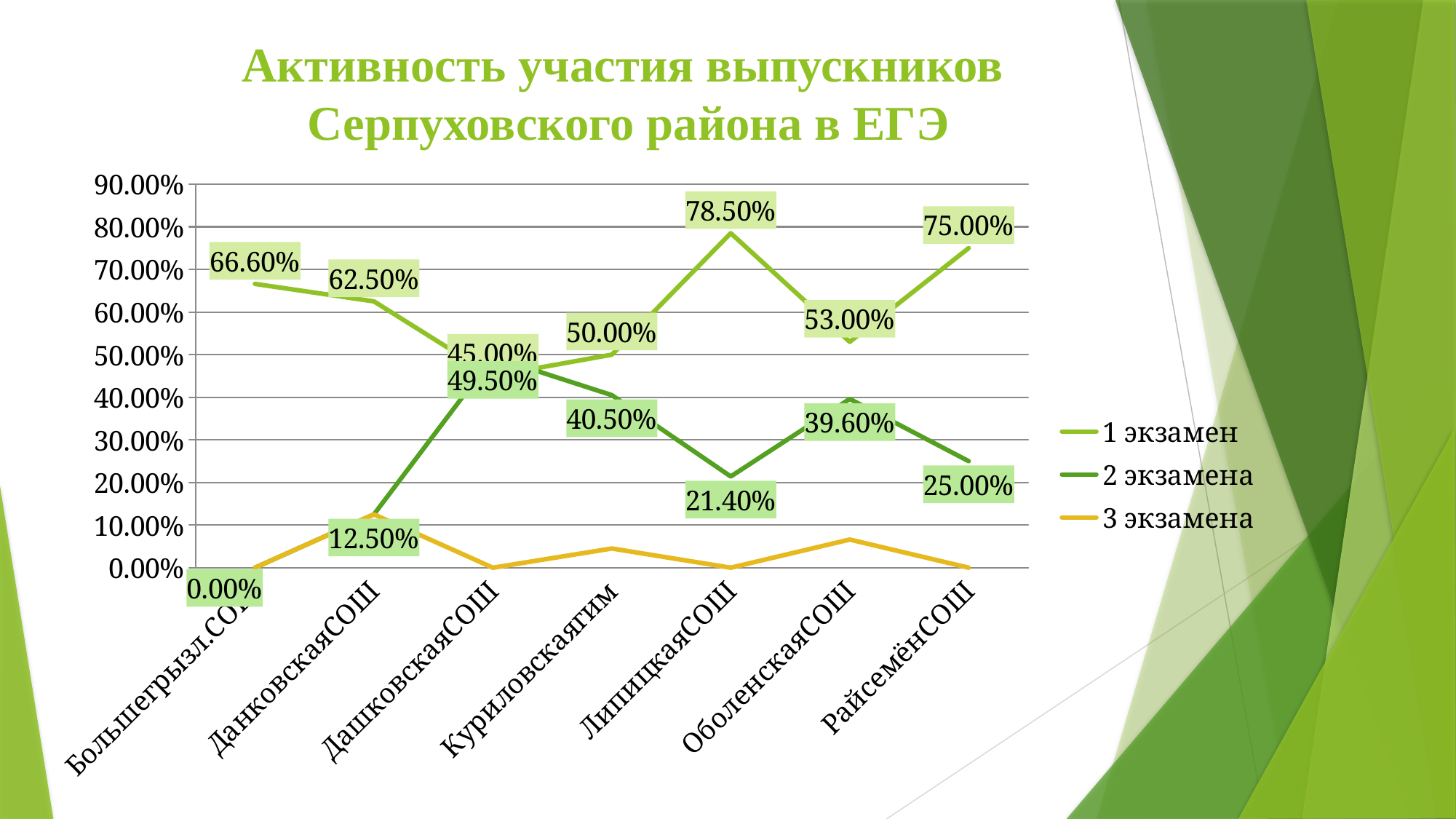
Which school has the highest value for 1 экзамен? ЛипицкаяСОШ How many schools are shown on the x axis? 7 What is the value for 1 экзамен at ЛипицкаяСОШ? 78.50% Which school has the lowest value for 2 экзамена? Большегрызл.СОШ What is the value for 1 экзамен at РайсемёнСОШ? 75.00% Which is larger: the 1 экзамен value at ЛипицкаяСОШ or at ОболенскаяСОШ? ЛипицкаяСОШ Which school has the highest value for 2 экзамена? ДашковскаяСОШ What is the value for 2 экзамена at Большегрызл.СОШ? 0.00% What kind of chart is shown on the slide? Line chart What is the difference between the 1 экзамен and 2 экзамена values at РайсемёнСОШ? 50.00% What is the value for 2 экзамена at ДашковскаяСОШ? 49.50% How many series does the legend list? 3